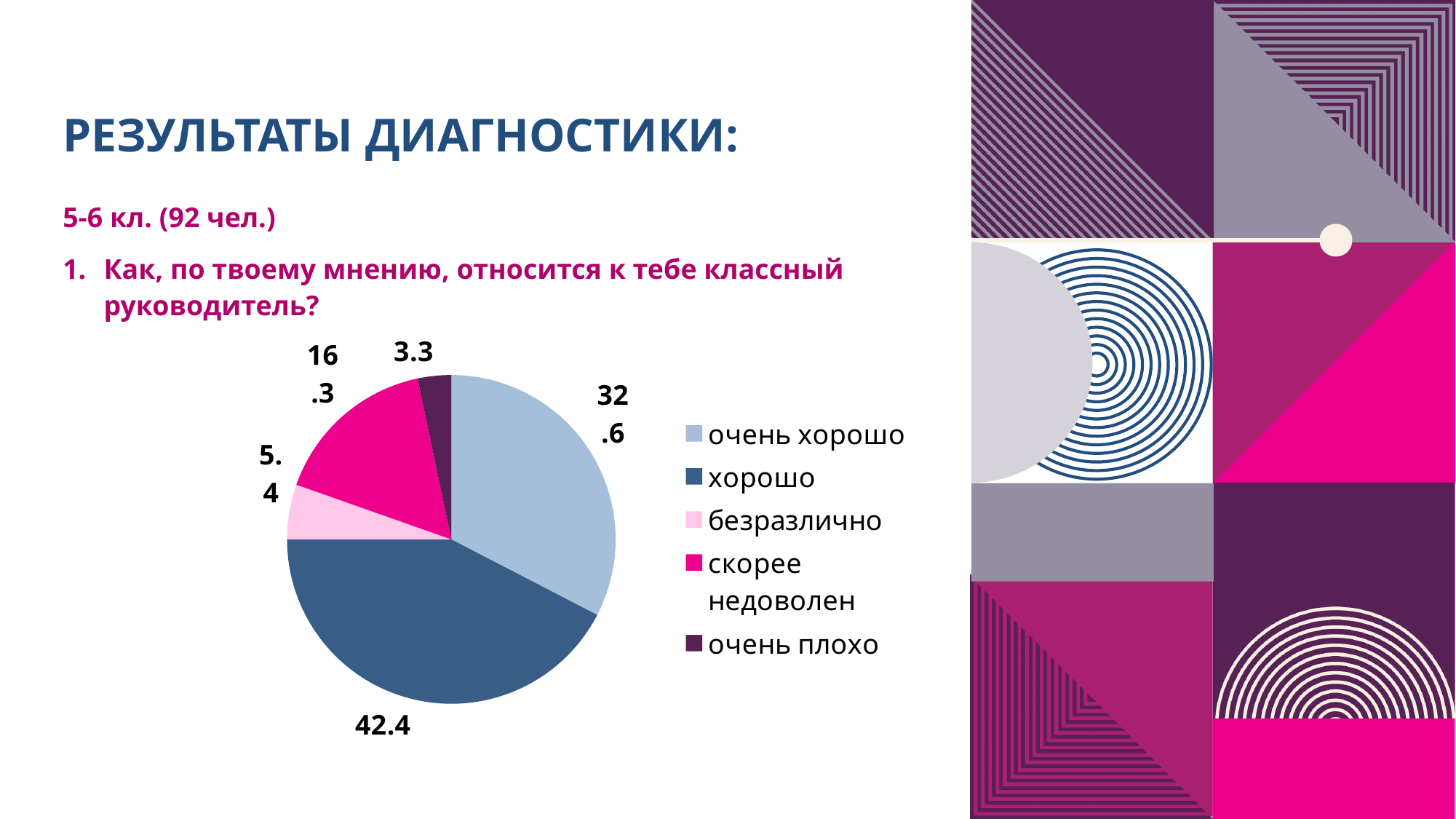
What is the value for "безразлично" in the pie chart? 5.4 What is the value for "скорее недоволен" in the pie chart? 16.3 What is the value for "хорошо" in the pie chart? 42.4 What is the value for "очень плохо" in the pie chart? 3.3 Which category has the largest slice in the pie chart? хорошо Which legend entry is shown in light blue? очень хорошо What is the difference between the values for "хорошо" and "очень хорошо"? 9.8 How many categories does the pie chart have? 5 Which category has the smallest slice in the pie chart? очень плохо Which is larger: the value for "скорее недоволен" or the value for "безразлично"? скорее недоволен What kind of chart is shown on the slide? pie chart What is the value for "очень хорошо" in the pie chart? 32.6